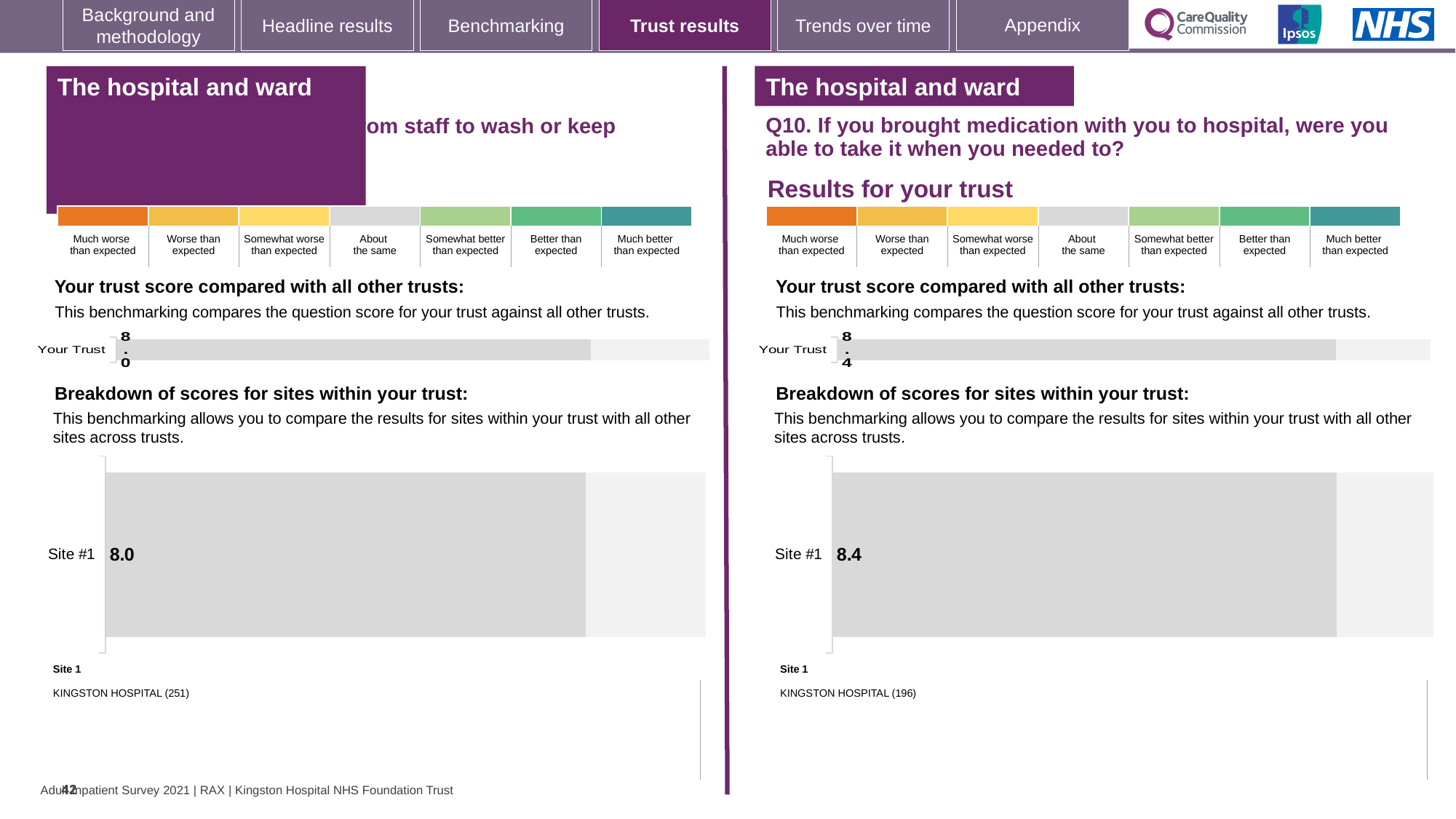
How many bars are plotted on the left-hand 'Your trust score compared with all other trusts' chart? 1 How many sites are plotted on the right-hand (Q10) 'Breakdown of scores for sites within your trust' chart? 1 On the right-hand (Q10) side, which hospital is listed as Site 1 below the breakdown chart? KINGSTON HOSPITAL (196) On the right-hand (Q10) 'Your trust score compared with all other trusts' chart, what is the score for Your Trust? 8.4 Which Site #1 score is larger: the one on the left-hand breakdown chart or the one on the right-hand (Q10) breakdown chart? The right-hand (Q10) chart What is the difference between the Site #1 score on the right-hand (Q10) breakdown chart and the Site #1 score on the left-hand breakdown chart? 0.4 How many categories does the colour scale above the right-hand (Q10) charts show, from 'Much worse than expected' to 'Much better than expected'? 7 On the left-hand 'Breakdown of scores for sites within your trust' chart, what is the score for Site #1? 8.0 On the left-hand 'Your trust score compared with all other trusts' chart, what is the score for Your Trust? 8.0 On the right-hand (Q10) 'Breakdown of scores for sites within your trust' chart, what is the score for Site #1? 8.4 What kind of chart is used for the 'Breakdown of scores for sites within your trust' on the right-hand (Q10) side? Bar chart